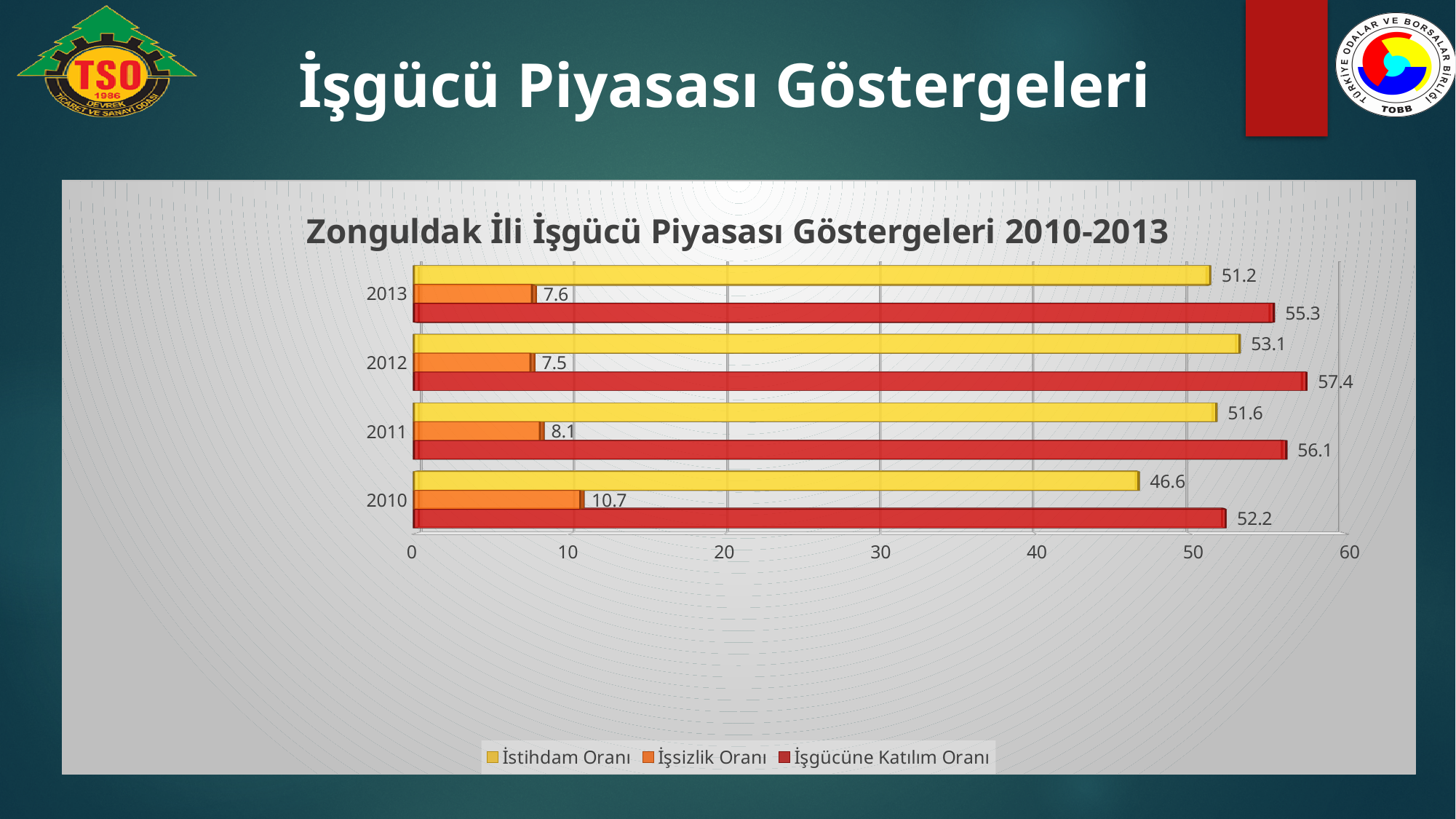
How many years are shown on the chart? 4 Which is larger, the İşsizlik Oranı in 2011 or in 2012? 2011 What is the title of the chart? Zonguldak İli İşgücü Piyasası Göstergeleri 2010-2013 What is the İşsizlik Oranı value for 2010? 10.7 Which year has the highest İşgücüne Katılım Oranı? 2012 What is the İşgücüne Katılım Oranı value for 2012? 57.4 What is the İstihdam Oranı value for 2013? 51.2 How many series does the legend list? 3 What kind of chart is shown on the slide? Bar chart What is the difference between the İşgücüne Katılım Oranı and the İstihdam Oranı in 2011? 4.5 Which year has the lowest İstihdam Oranı? 2010 Does the İşsizlik Oranı rise or fall from 2010 to 2013? Fall